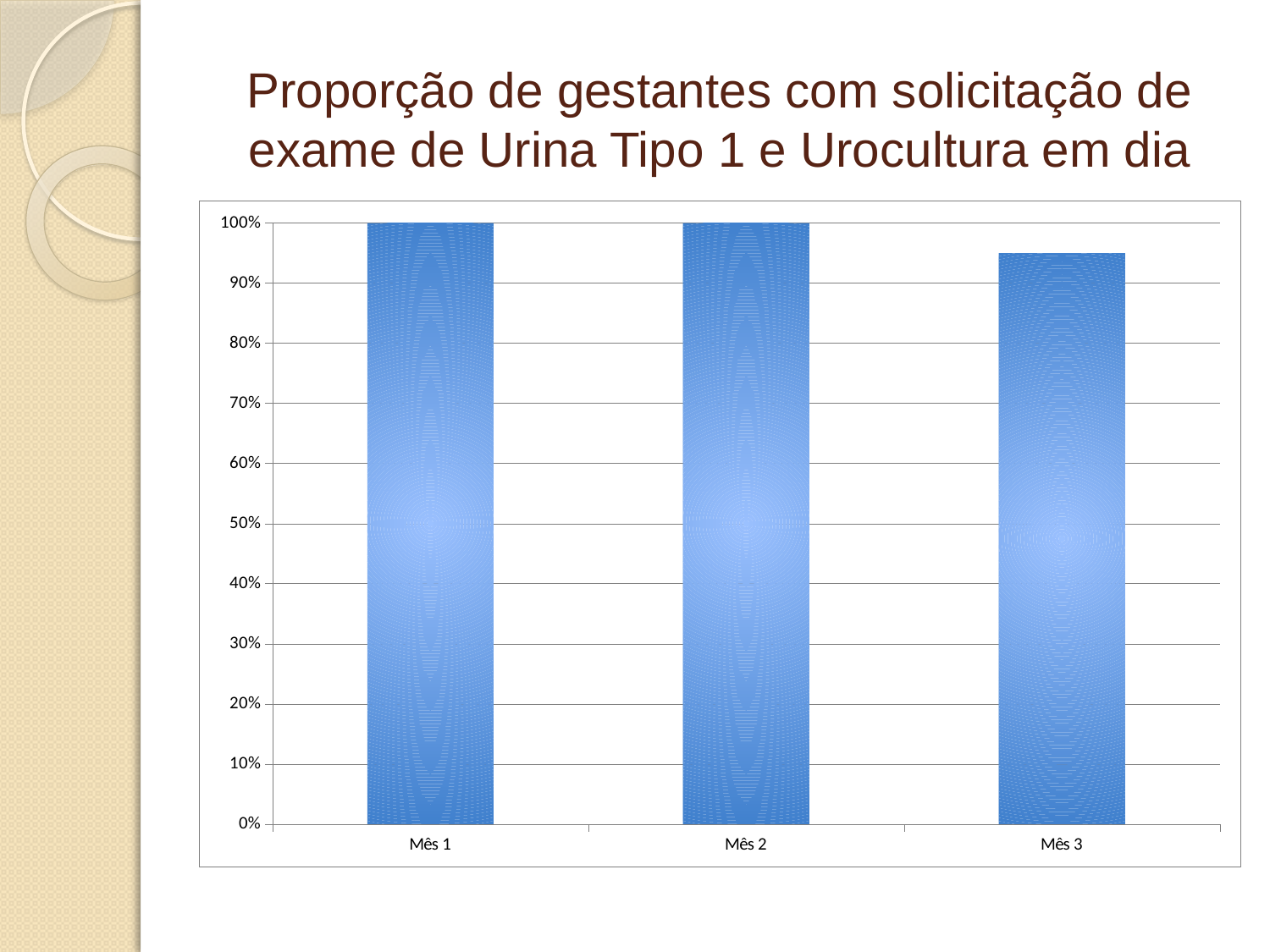
What is the title of the slide? Proporção de gestantes com solicitação de exame de Urina Tipo 1 e Urocultura em dia What is the value for Mês 1? 100% Which is larger, the value for Mês 1 or the value for Mês 3? Mês 1 Is the value for Mês 3 greater or less than 100%? less What kind of chart is shown on the slide? Bar chart Which month has the lowest value? Mês 3 Is the value for Mês 3 greater or less than 90%? greater Do the values rise or fall from Mês 1 to Mês 3? fall How many months are shown on the x axis? 3 Which is larger, the value for Mês 2 or the value for Mês 3? Mês 2